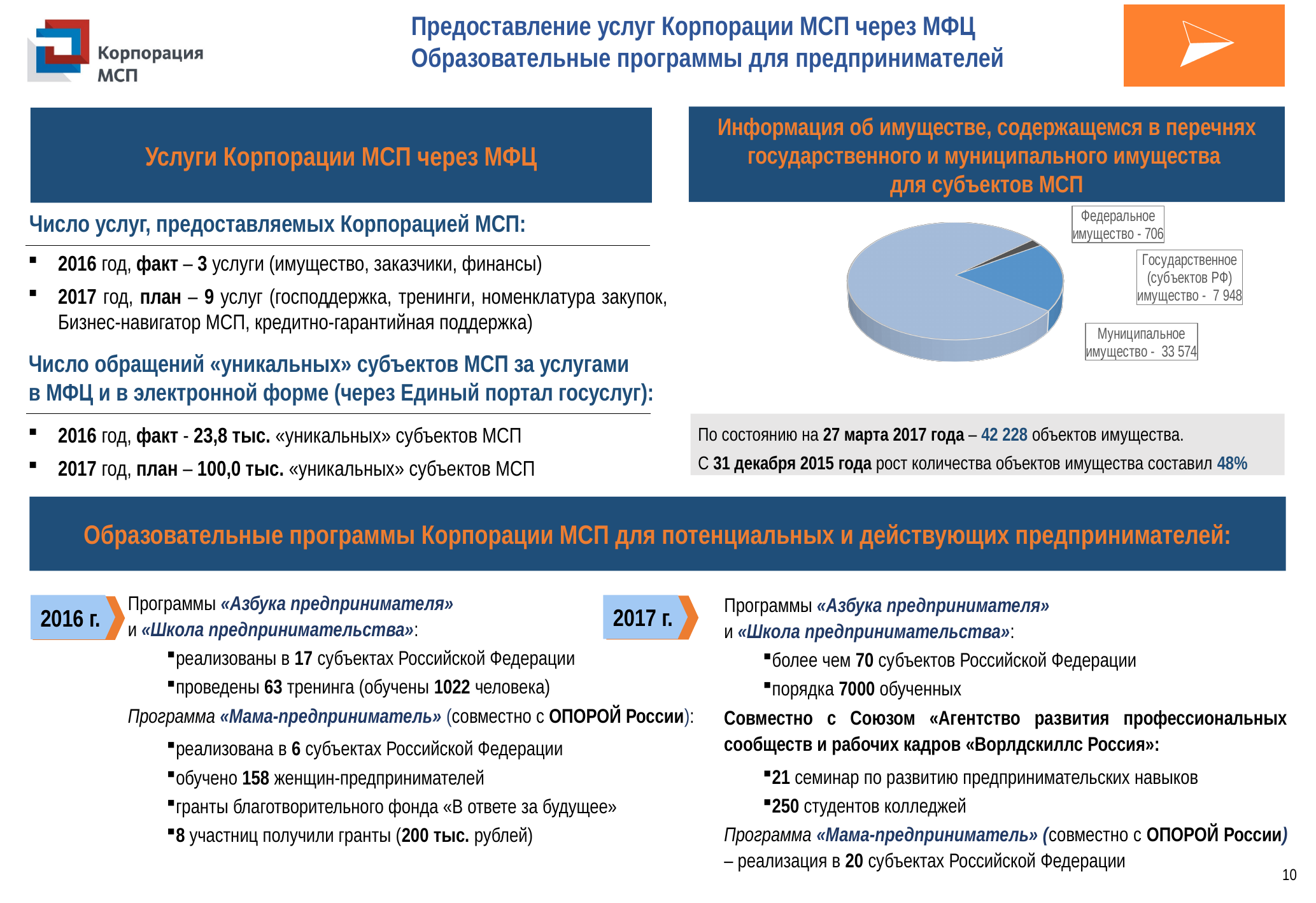
What kind of chart is used to show the property information? Pie chart Which category has the largest slice in the pie chart? Муниципальное имущество What is the value for Государственное (субъектов РФ) имущество in the pie chart? 7 948 What is the difference between the values for Муниципальное имущество and Государственное (субъектов РФ) имущество? 25 626 What is the total of all three slices in the pie chart? 42 228 Which is larger: Государственное (субъектов РФ) имущество or Федеральное имущество? Государственное (субъектов РФ) имущество Which category has the smallest slice in the pie chart? Федеральное имущество What is the title of the section containing the pie chart? Информация об имуществе, содержащемся в перечнях государственного и муниципального имущества для субъектов МСП What is the value for Федеральное имущество in the pie chart? 706 What is the value for Муниципальное имущество in the pie chart? 33 574 How many categories are shown in the pie chart? 3 What is the difference between the values for Государственное (субъектов РФ) имущество and Федеральное имущество? 7 242